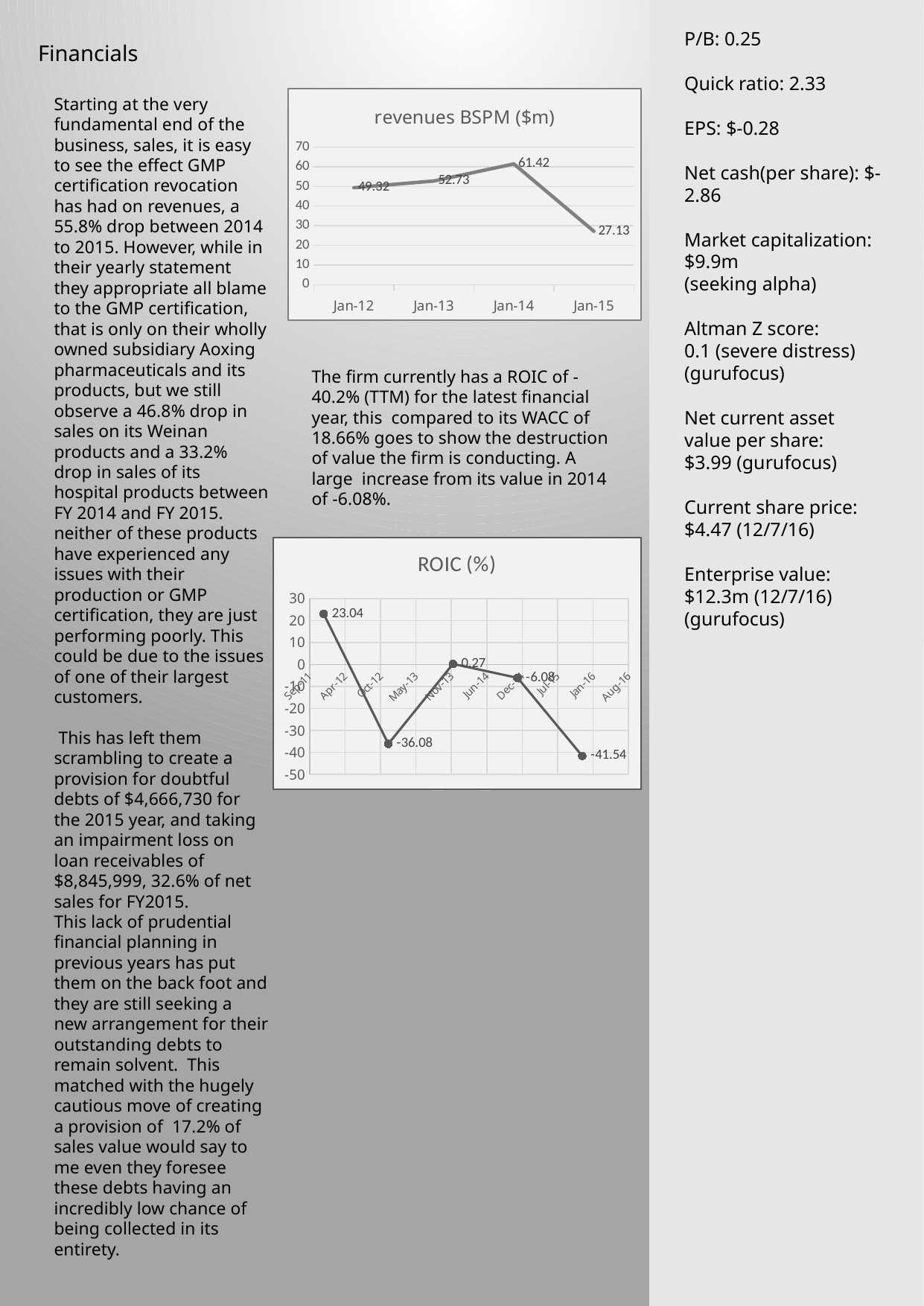
In the 'ROIC (%)' chart, what is the lowest plotted value? -41.54 In the 'revenues BSPM ($m)' chart, what is the difference between the Jan-14 and Jan-15 values? 34.29 How many data points are plotted in the 'revenues BSPM ($m)' chart? 4 How many data points are plotted in the 'ROIC (%)' chart? 5 What type of chart is the 'ROIC (%)' chart? Line chart In the 'revenues BSPM ($m)' chart, what is the revenue value for Jan-12? 49.32 In the 'revenues BSPM ($m)' chart, which year has the lowest revenue? Jan-15 In the 'revenues BSPM ($m)' chart, is the value for Jan-13 larger than the value for Jan-12? Yes In the 'revenues BSPM ($m)' chart, what is the revenue value for Jan-14? 61.42 In the 'ROIC (%)' chart, what is the highest plotted value? 23.04 In the 'revenues BSPM ($m)' chart, what is the revenue value for Jan-15? 27.13 In the 'revenues BSPM ($m)' chart, which year has the highest revenue? Jan-14